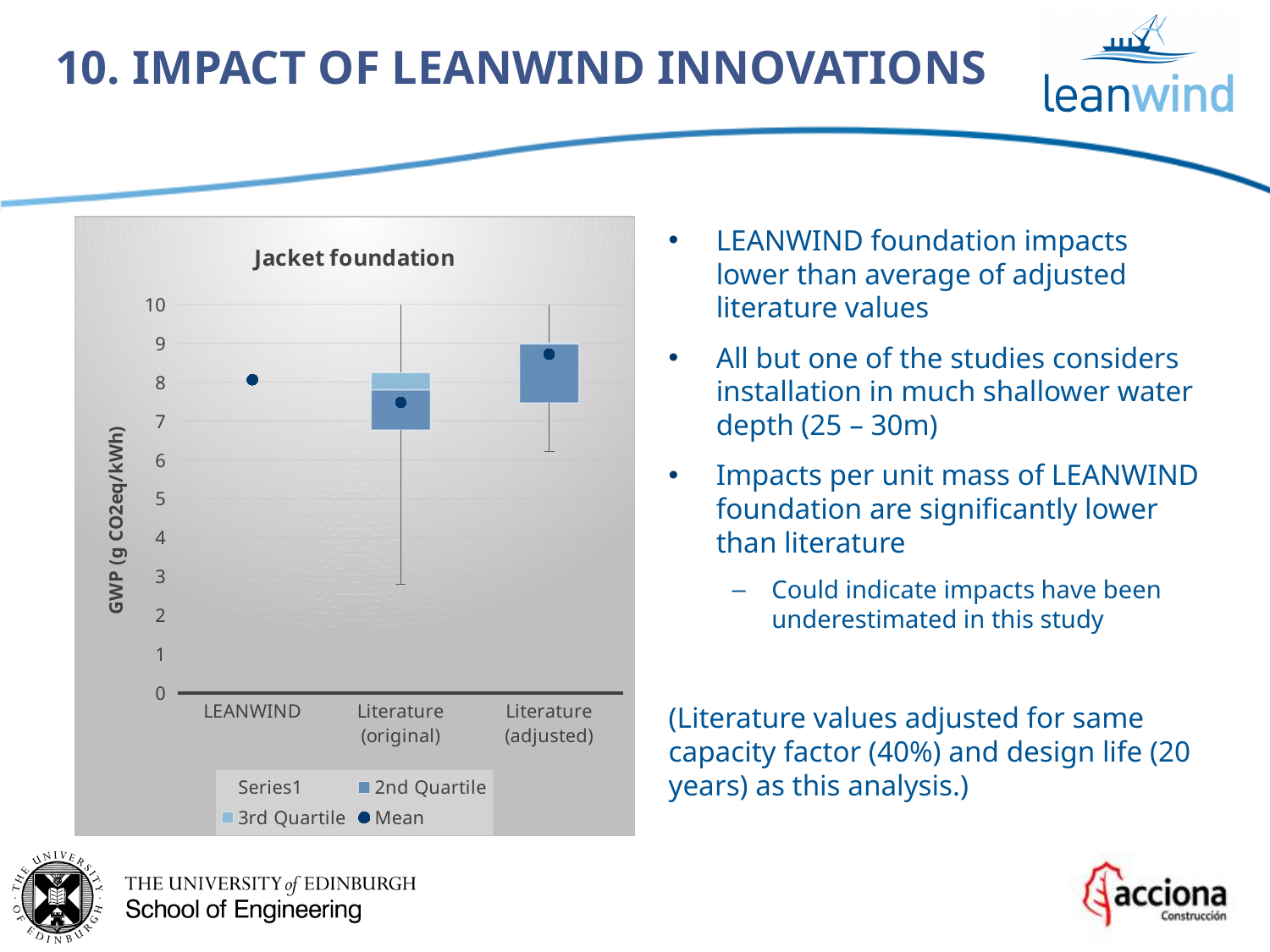
What kind of chart is shown on the slide? Box-and-whisker chart Is the mean value for Literature (original) greater or less than 7? greater Which has a larger mean value, LEANWIND or Literature (original)? LEANWIND How many entries does the chart's legend list? 4 Is the mean value for Literature (adjusted) greater or less than 9? less What is the y-axis label of the chart? GWP (g CO2eq/kWh) How many categories are shown on the x axis of the chart? 3 Is the mean value for Literature (adjusted) greater or less than 8? greater Which has a larger mean value, LEANWIND or Literature (adjusted)? Literature (adjusted) What is the title of the chart? Jacket foundation Which category has the lowest mean value? Literature (original) Which category has the highest mean value? Literature (adjusted)